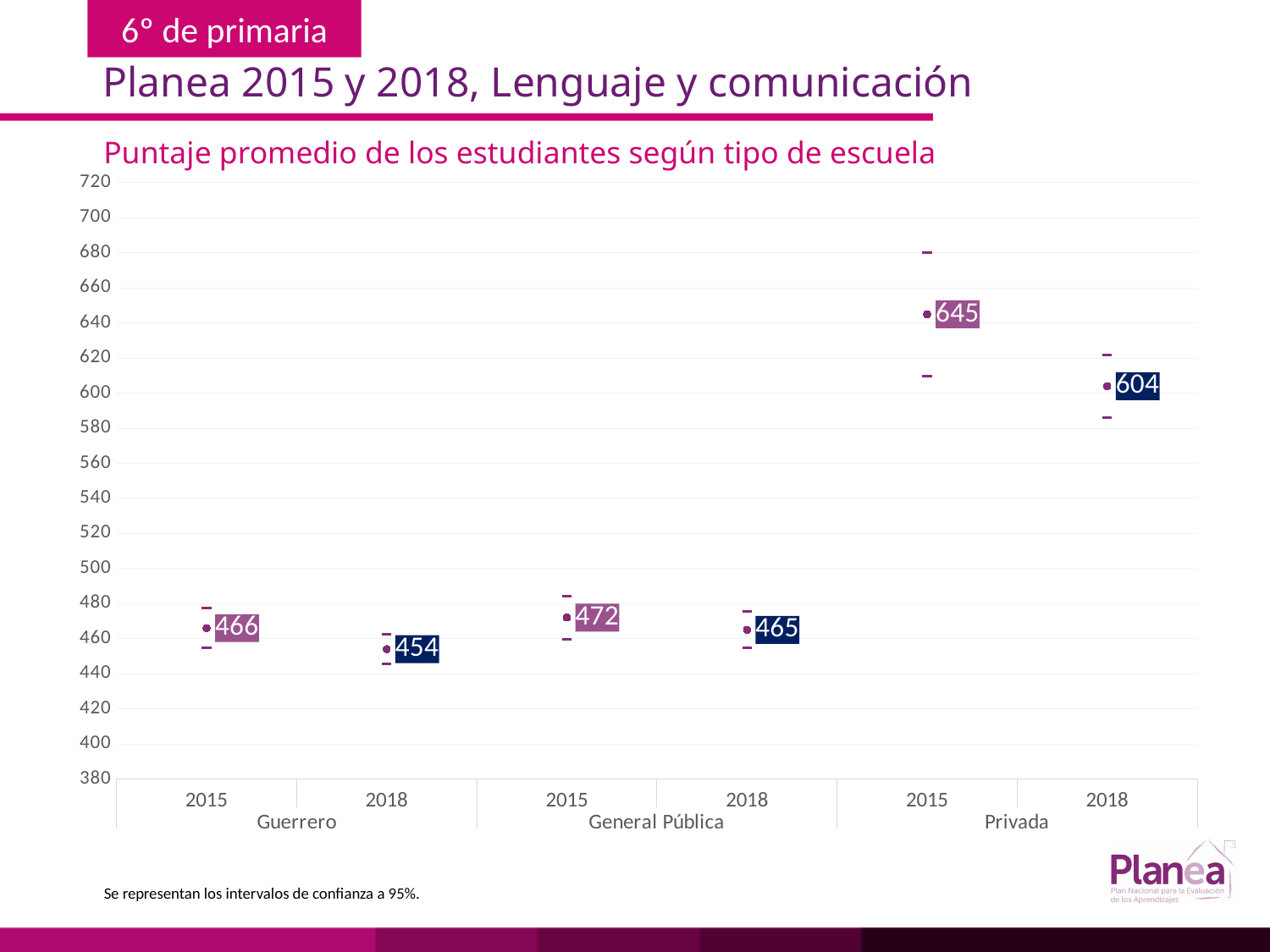
What is the title of the chart? Puntaje promedio de los estudiantes según tipo de escuela Which group and year has the highest average score? Privada 2015 What is the average score for Guerrero in 2015? 466 Did the scores rise or fall from 2015 to 2018 for each school type? fall Is the 2015 score for Privada greater or less than 620? greater What is the difference between the Privada scores in 2015 and 2018? 41 Which is larger, the 2018 score for Guerrero or the 2018 score for General Pública? General Pública What is the average score for General Pública in 2015? 472 What is the average score for Privada schools in 2018? 604 How many data points are plotted on the chart? 6 By how many points did the Guerrero score change from 2015 to 2018? 12 Which group and year has the lowest average score? Guerrero 2018